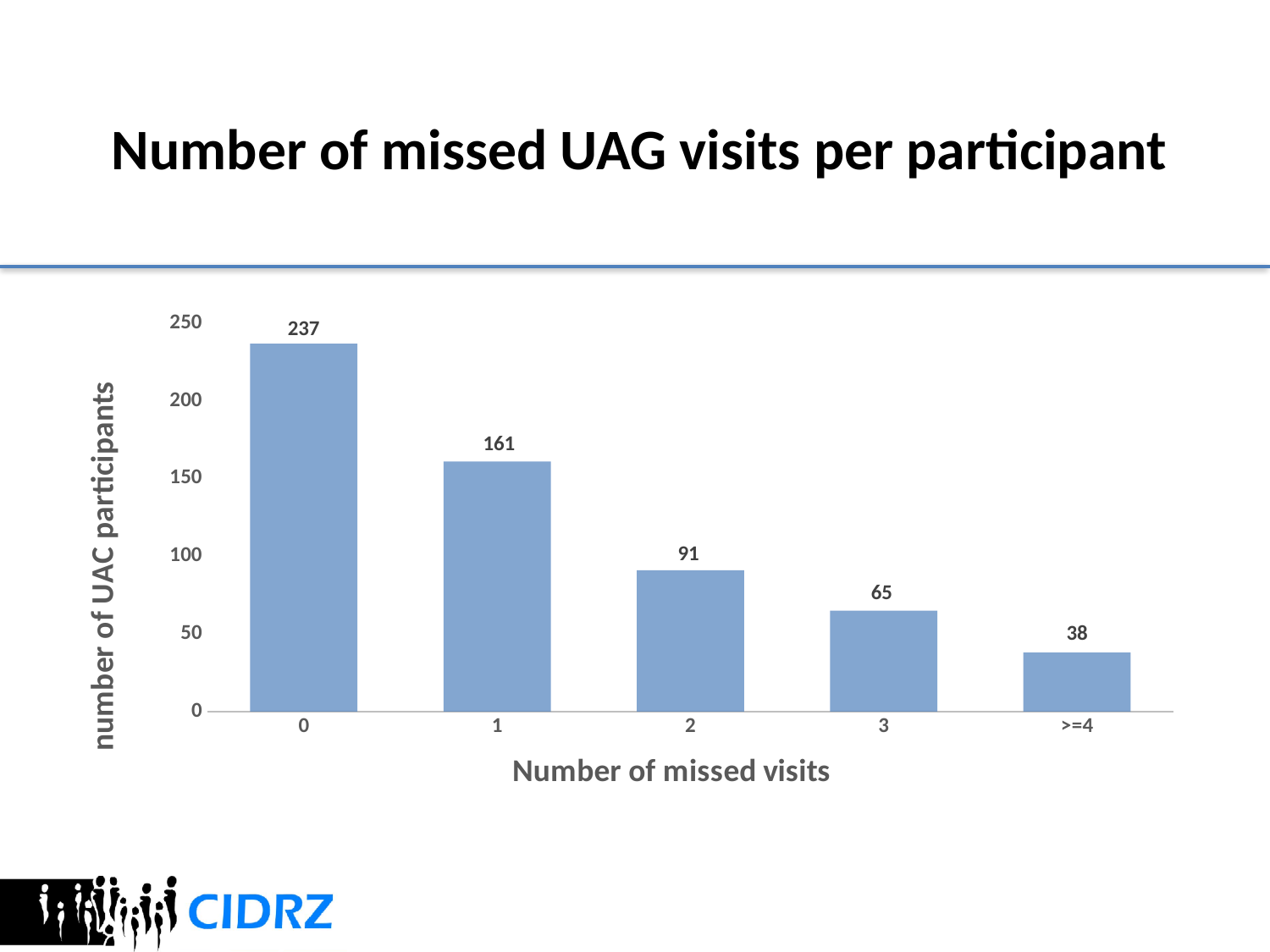
What is the difference between the number of participants with 0 missed visits and those with 1 missed visit? 76 Which number of missed visits has the lowest number of participants? >=4 What kind of chart is shown on the slide? Bar chart How many UAC participants missed >=4 visits? 38 Do the values rise or fall as the number of missed visits increases along the x axis? Fall Which has more participants: 2 missed visits or 3 missed visits? 2 missed visits How many UAC participants missed 0 visits? 237 How many UAC participants missed 3 visits? 65 Which number of missed visits has the highest number of participants? 0 How many categories of missed visits are shown on the x axis? 5 How many UAC participants missed 2 visits? 91 How many UAC participants missed 1 visit? 161